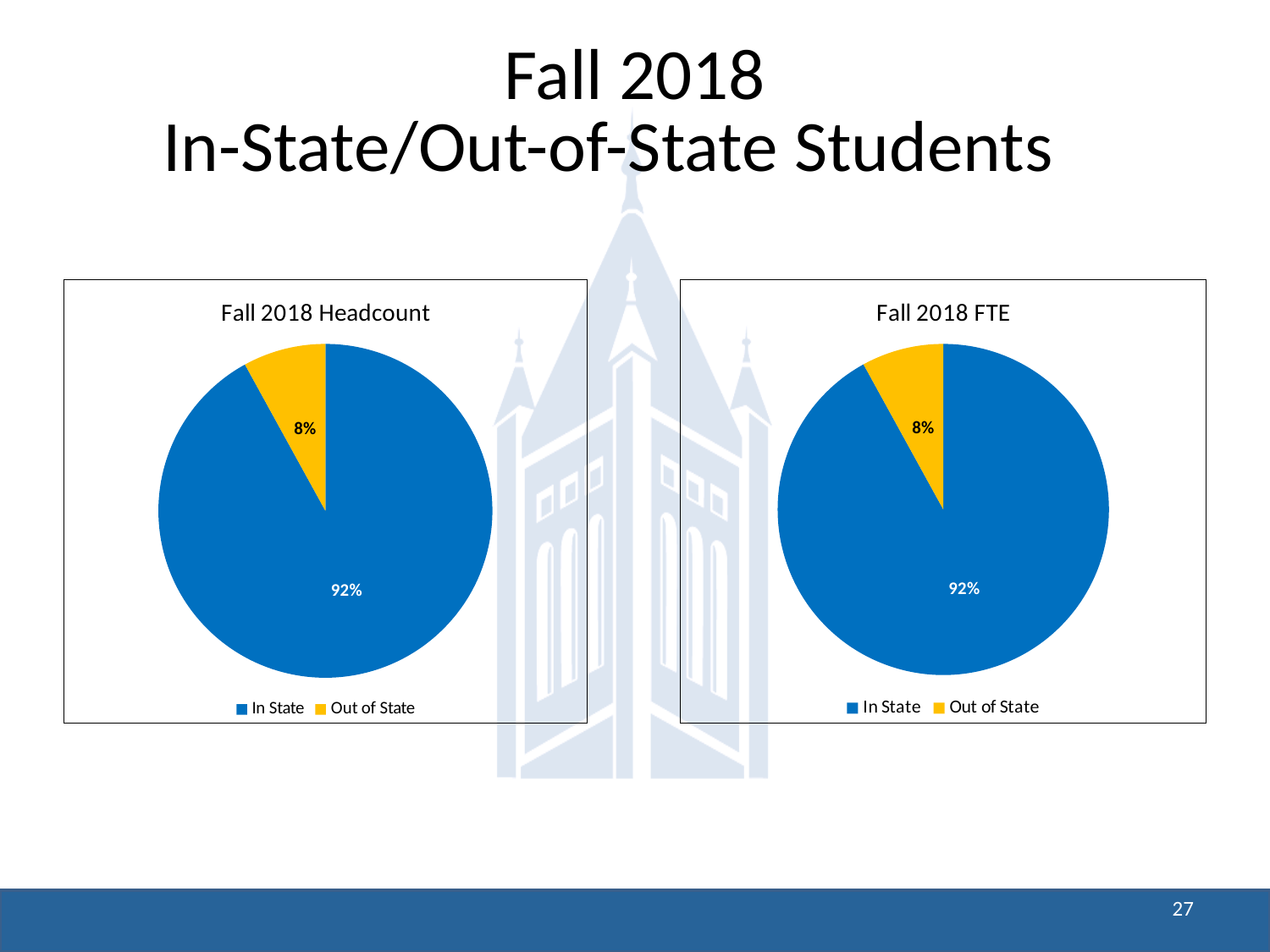
What kind of chart is the Fall 2018 Headcount chart? Pie chart In the Fall 2018 Headcount chart, which category has the largest slice? In State In the Fall 2018 FTE chart, which is larger, In State or Out of State? In State How many slices does the Fall 2018 FTE pie chart have? 2 In the Fall 2018 FTE chart, what share is Out of State? 8% In the Fall 2018 FTE chart, which category has the smallest slice? Out of State In the Fall 2018 Headcount chart, what share of students are In State? 92% How many entries does the legend of the Fall 2018 Headcount chart list? 2 In the Fall 2018 Headcount chart, what is the difference in percentage points between In State and Out of State? 84 percentage points In the Fall 2018 Headcount chart, what share of students are Out of State? 8% In the Fall 2018 FTE chart, what share is In State? 92% In the Fall 2018 FTE chart, what colour represents Out of State? Yellow